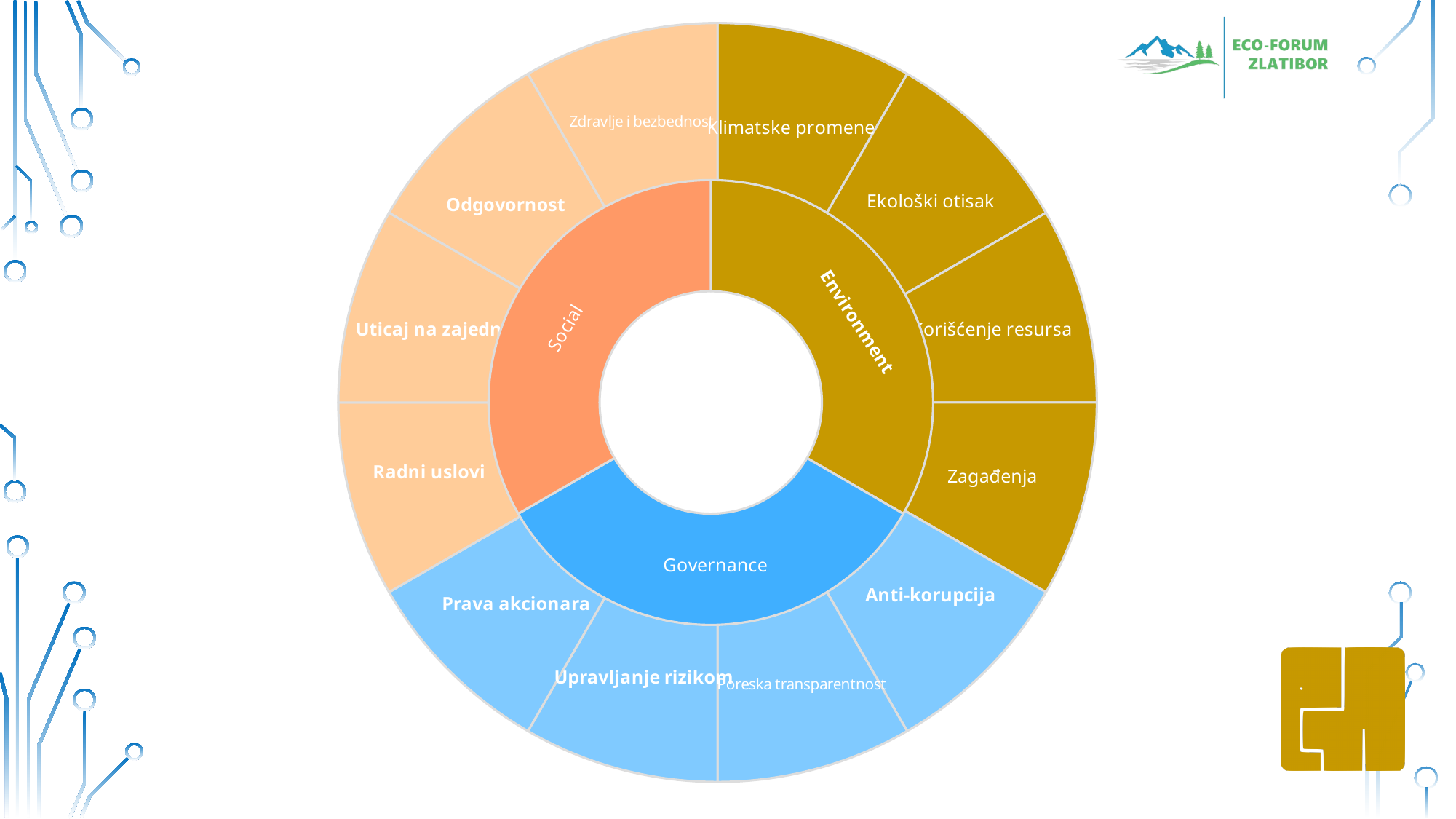
How many sub-categories are shown in the outer ring under Social? 4 How many sub-categories are shown in the outer ring under Governance? 4 How many top-level categories are shown in the inner ring of the chart? 3 Which top-level category does the segment Radni uslovi belong to? Social Which top-level category does the segment Zagađenja belong to? Environment What colour is used for the Governance section of the chart? Blue What are the three labels shown in the inner ring of the chart? Social, Environment, Governance What kind of chart is shown on the slide? Sunburst chart Which top-level category does the segment Anti-korupcija belong to? Governance